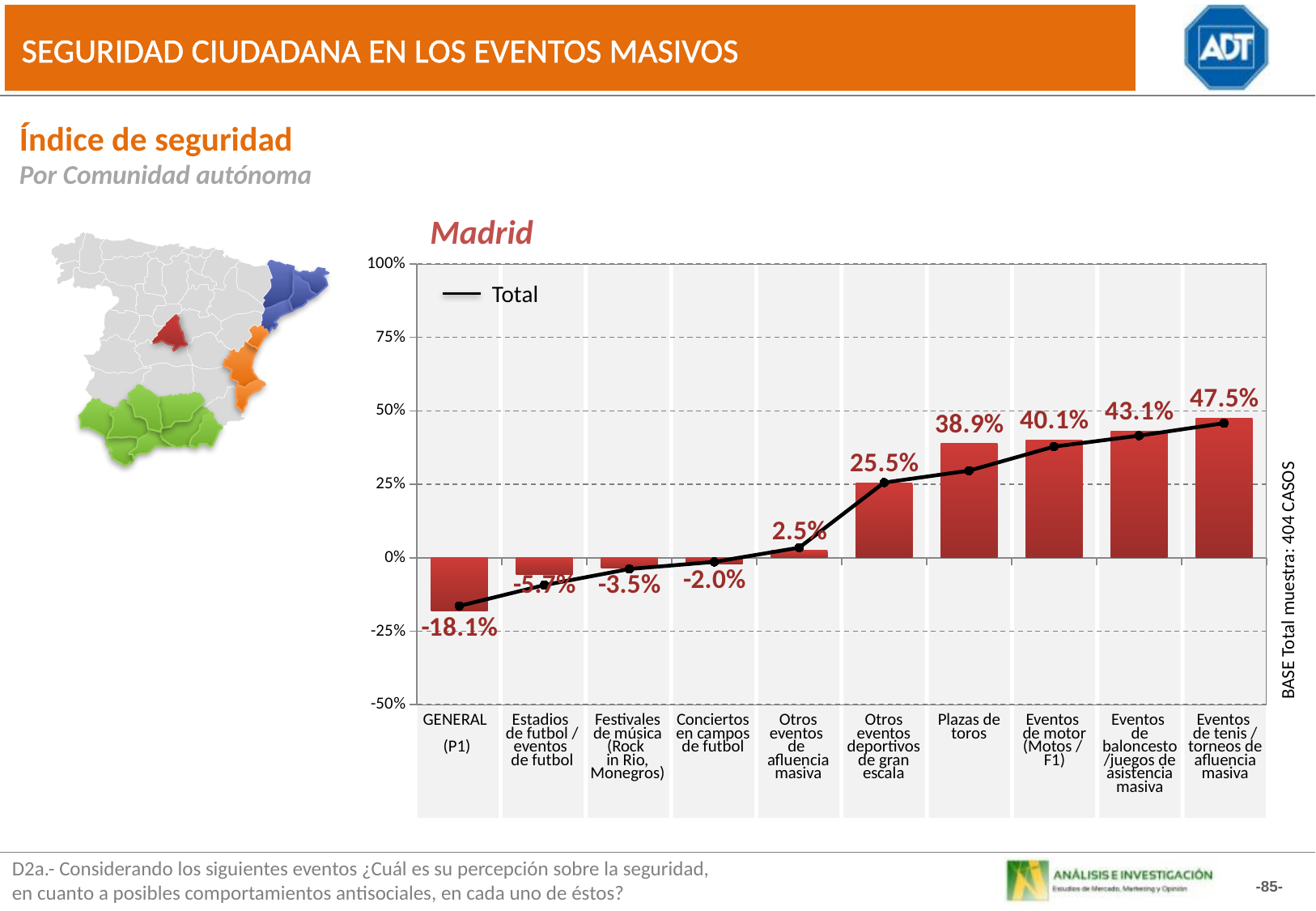
How many series does the legend list? 1 What is the difference between the values for Eventos de tenis / torneos de afluencia masiva and Eventos de baloncesto /juegos de asistencia masiva? 4.4% What is the value shown for GENERAL (P1) in the Madrid chart? -18.1% What is the title of the chart? Madrid Is the value for Plazas de toros greater or less than 25%? greater What is the value shown for Plazas de toros in the Madrid chart? 38.9% What is the value shown for Eventos de motor (Motos / F1)? 40.1% How many categories are shown on the x axis of the Madrid chart? 10 Which has a larger value: Festivales de música (Rock in Rio, Monegros) or Conciertos en campos de futbol? Conciertos en campos de futbol Which category has the highest value in the Madrid chart? Eventos de tenis / torneos de afluencia masiva Which category has the lowest value in the Madrid chart? GENERAL (P1) What is the value shown for Otros eventos deportivos de gran escala? 25.5%